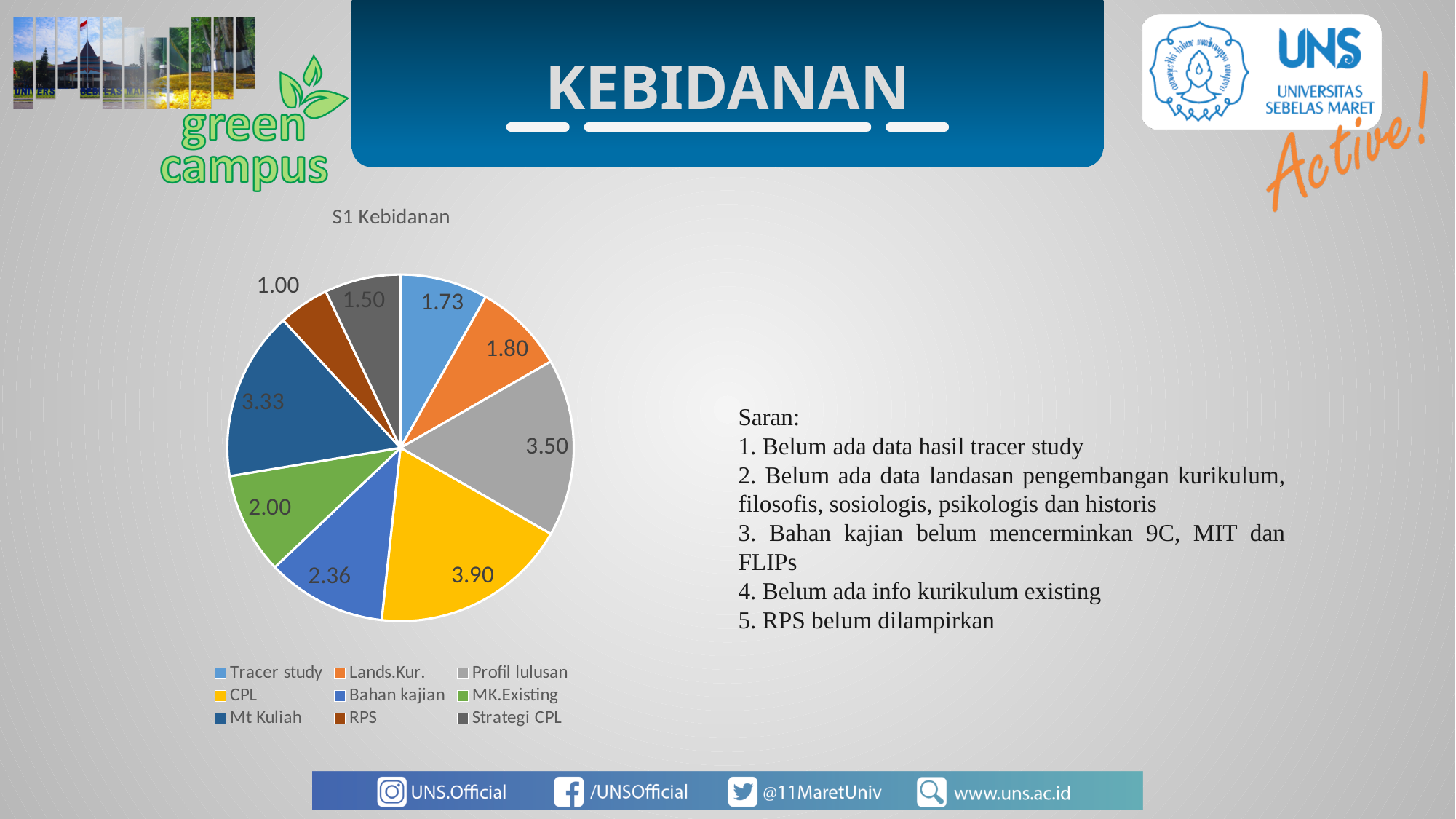
How many slices does the pie chart have? 9 What is the value for Mt Kuliah? 3.33 What is the value for Bahan kajian? 2.36 Which category has the largest slice? CPL Which category has the smallest slice? RPS What is the difference between the values for CPL and Profil lulusan? 0.40 What type of chart is shown on the slide? Pie chart Which is larger, the value for Mt Kuliah or the value for MK.Existing? Mt Kuliah What is the title of the chart? S1 Kebidanan What colour is the Strategi CPL slice? Dark grey What is the value for CPL? 3.90 What is the value for Tracer study? 1.73